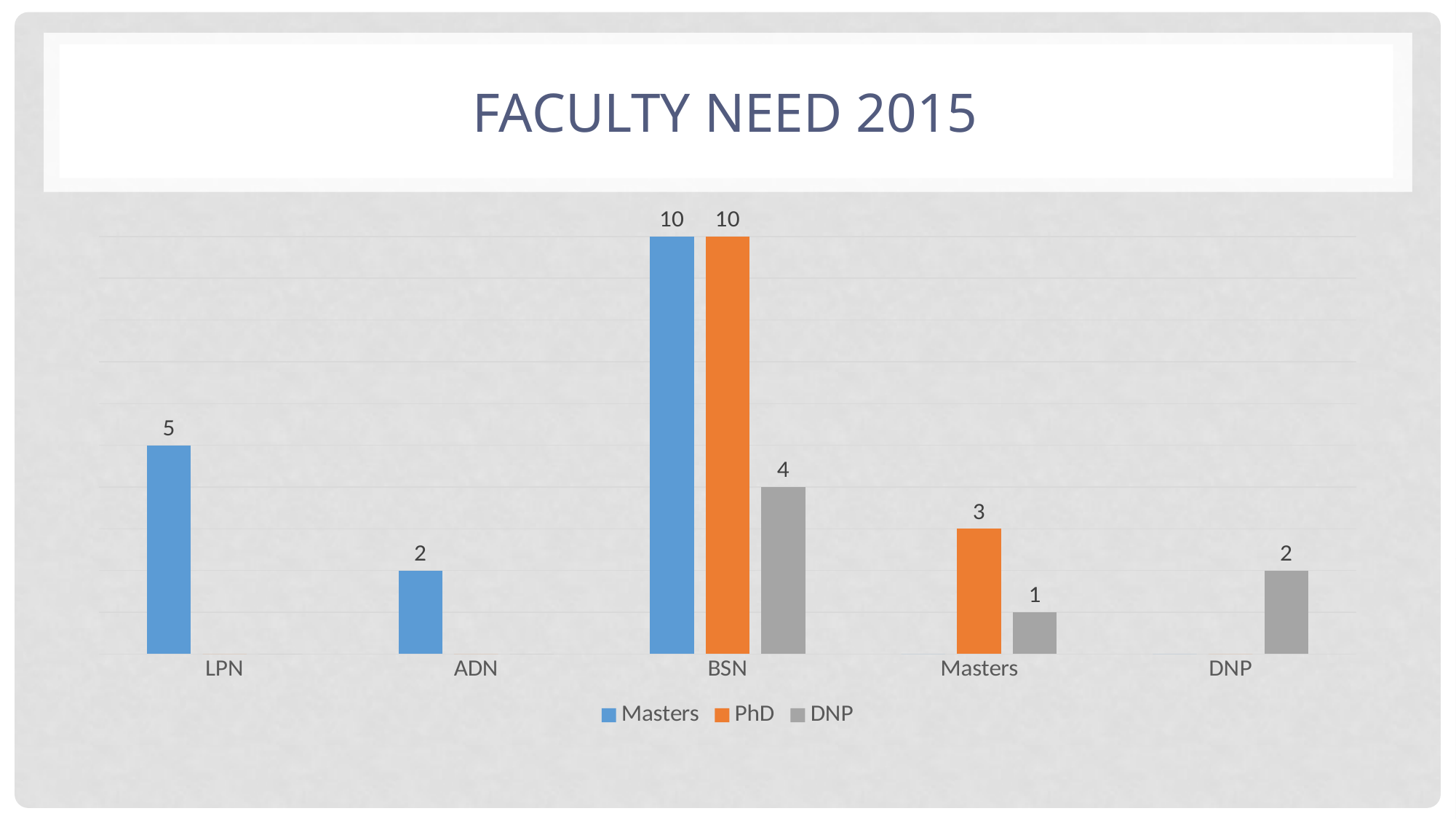
What is the Masters value for LPN? 5 What is the PhD value for BSN? 10 What is the DNP value for DNP? 2 What kind of chart is shown on the slide? bar chart Which category has the lowest Masters value among those with a labelled Masters bar? ADN How many categories are shown on the x axis? 5 What is the difference between the PhD value for BSN and the PhD value for Masters? 7 Is the Masters value for LPN larger or smaller than the Masters value for ADN? larger How many series does the legend list? 3 Which category has the highest DNP value? BSN What is the title of the chart? FACULTY NEED 2015 What is the DNP value for Masters? 1